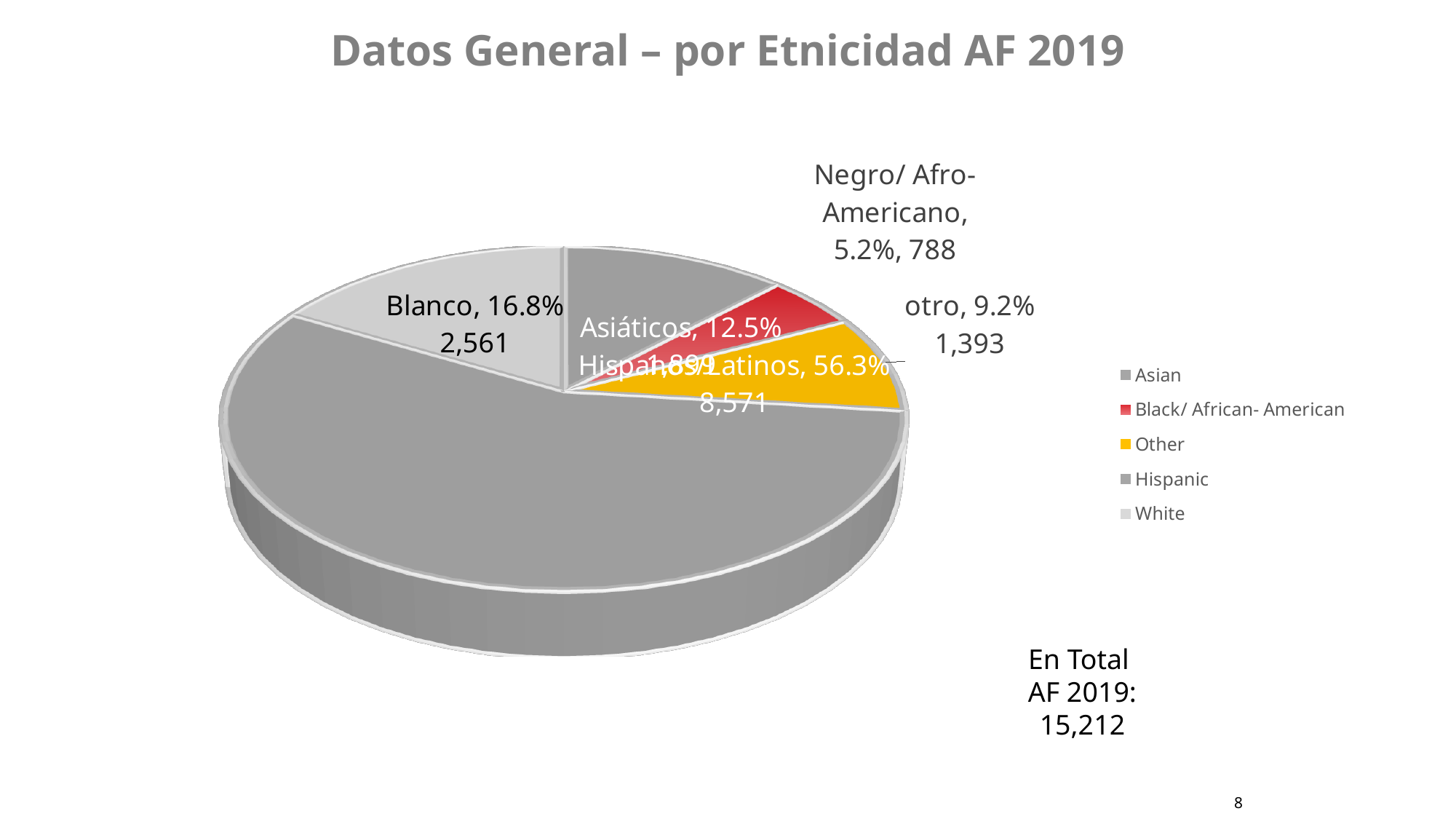
What is the count shown for otro? 1,393 What percentage share does the Negro/Afro-Americano slice have? 5.2% How many entries does the legend list? 5 What is the count shown for Hispanos/Latinos? 8,571 What is the difference in count between Blanco and otro? 1,168 Which category has the largest slice of the pie? Hispanos/Latinos Which category has the smallest slice of the pie? Negro/Afro-Americano What percentage share does the Asiáticos slice have? 12.5% What percentage share does the Hispanos/Latinos slice have? 56.3% What kind of chart is shown on the slide? pie chart Which is larger, the Blanco slice or the Asiáticos slice? Blanco What is the count shown for Blanco? 2,561